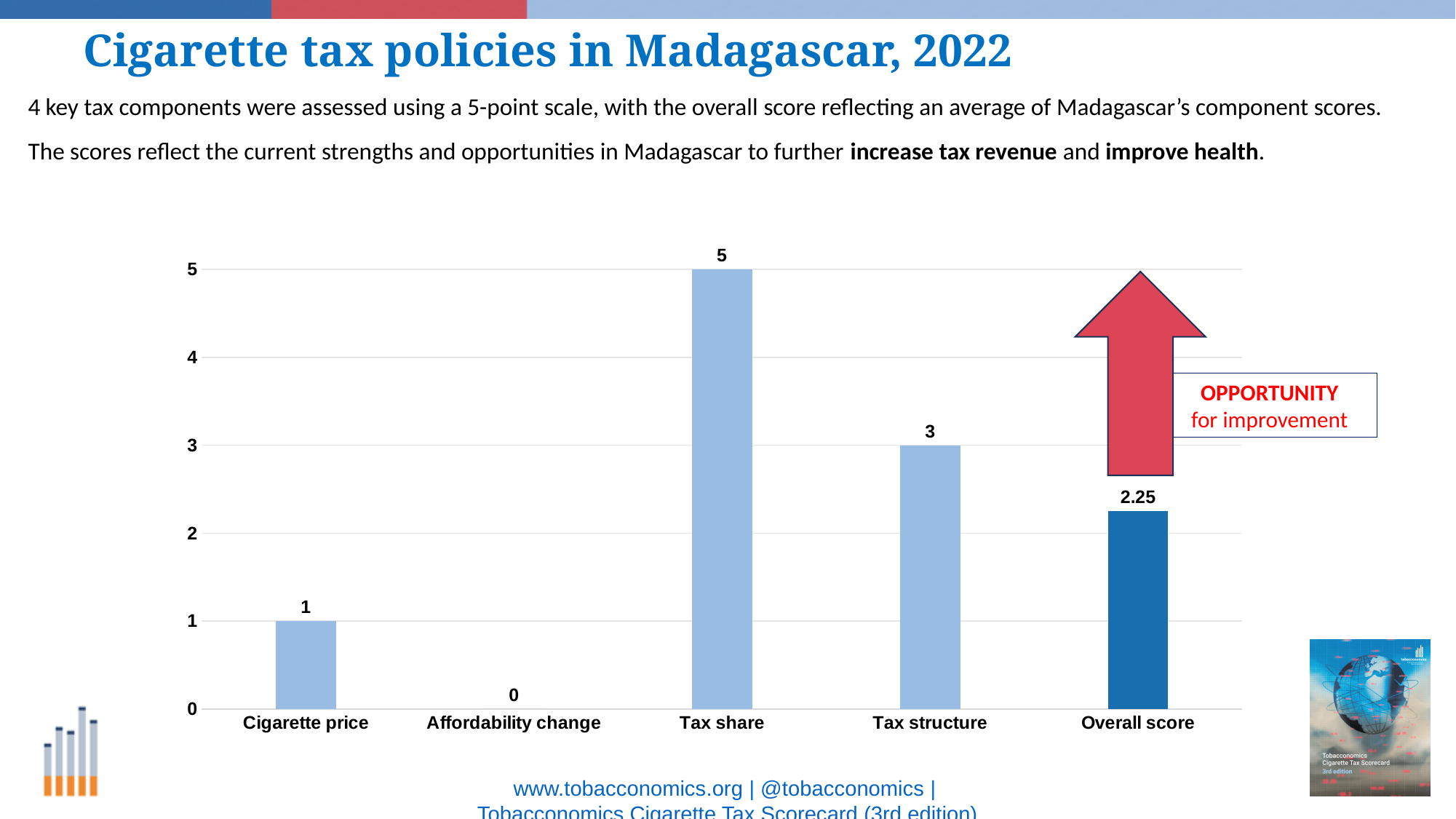
Is the Overall score greater or less than 3? less Which is larger, the score for Tax structure or the score for Cigarette price? Tax structure What text appears in the box next to the red arrow? OPPORTUNITY for improvement What is the score for Affordability change? 0 What is the Overall score shown on the chart? 2.25 What is the score for Cigarette price? 1 What is the score for Tax share? 5 What is the difference between the Tax share score and the Tax structure score? 2 Which category has the highest score? Tax share How many categories are shown on the x axis? 5 What kind of chart is shown on the slide? bar chart Which category has the lowest score? Affordability change